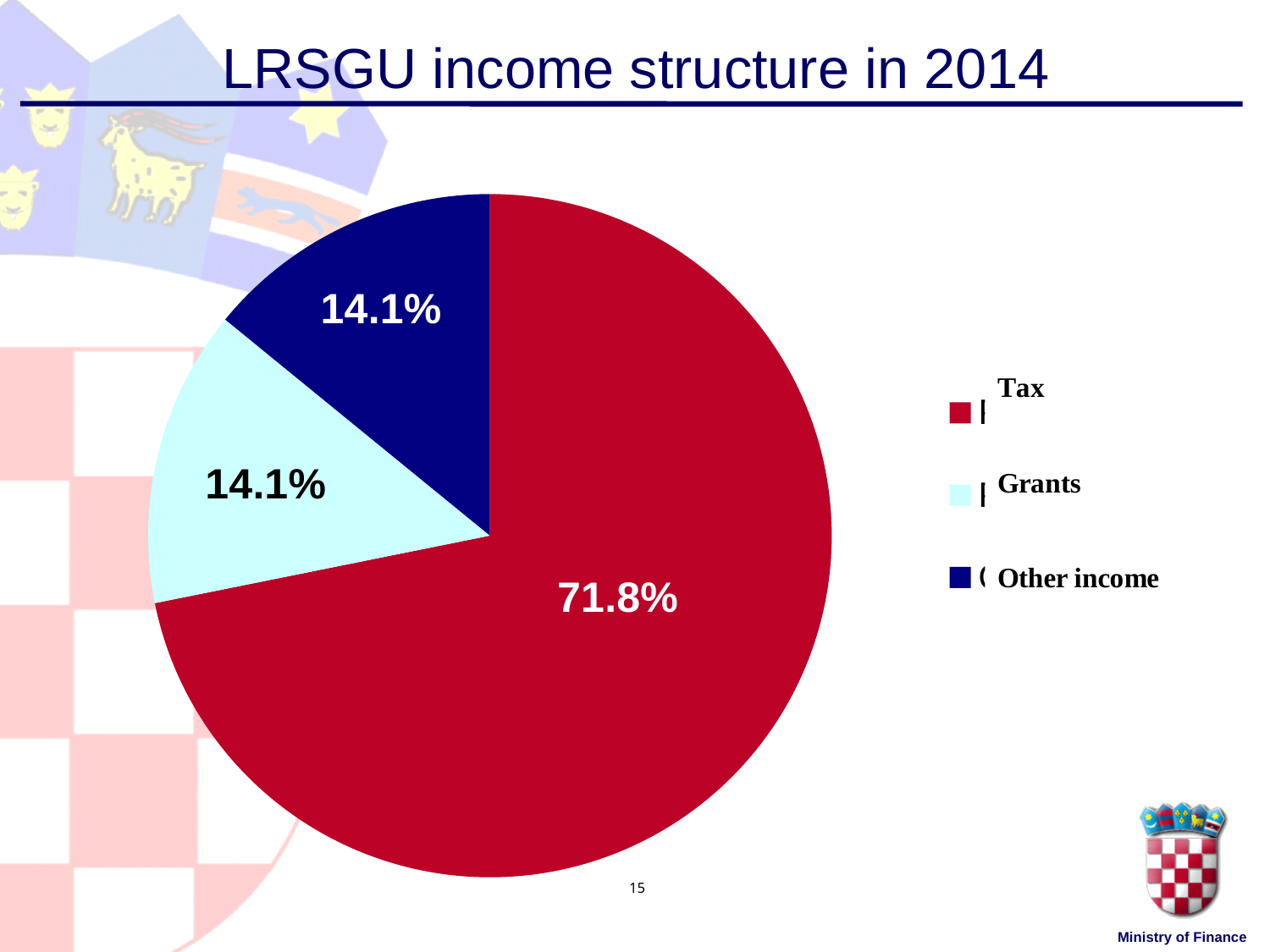
Is the share for Tax greater or less than 50%? greater Which colour represents Grants in the pie chart? light blue What is the difference in percentage points between the Tax share and the Grants share? 57.7 What share of LRSGU income in 2014 comes from Tax? 71.8% What share of LRSGU income in 2014 comes from Grants? 14.1% What share of LRSGU income in 2014 comes from Other income? 14.1% How many entries does the legend list? 3 Which is larger, the share for Tax or the share for Other income? Tax How many slices does the pie chart have? 3 What is the title of the chart on the slide? LRSGU income structure in 2014 What kind of chart is shown on the slide? pie chart Which income category has the largest share of the pie? Tax